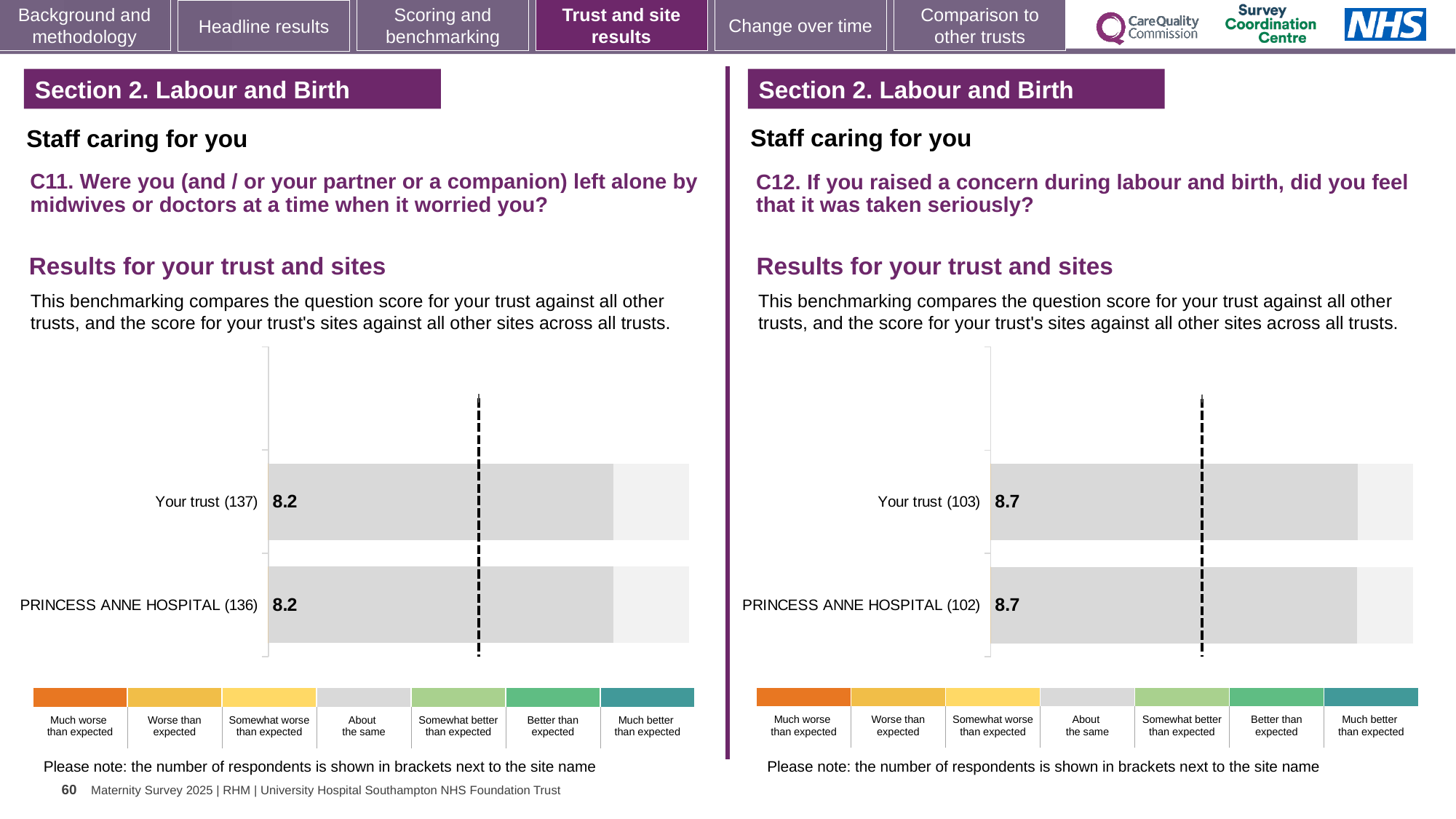
In the C12 chart on the right, what is the score for PRINCESS ANNE HOSPITAL? 8.7 In the C12 chart on the right, what is the difference between the score for Your trust and the score for PRINCESS ANNE HOSPITAL? 0 In the C12 chart on the right, what is the score for Your trust? 8.7 How many bars are plotted in the C12 chart on the right? 2 In the C11 chart on the left, what is the score for Your trust? 8.2 In the C11 chart on the left, what is the difference between the score for Your trust and the score for PRINCESS ANNE HOSPITAL? 0 What type of chart is used in the C11 chart on the left? Bar chart In the C12 chart on the right, how many respondents are shown in brackets for Your trust? 103 In the C11 chart on the left, how many respondents are shown in brackets for PRINCESS ANNE HOSPITAL? 136 In the C11 chart on the left, what is the score for PRINCESS ANNE HOSPITAL? 8.2 Is the score for Your trust in the C12 chart on the right larger than the score for Your trust in the C11 chart on the left? Yes How many bars are plotted in the C11 chart on the left? 2